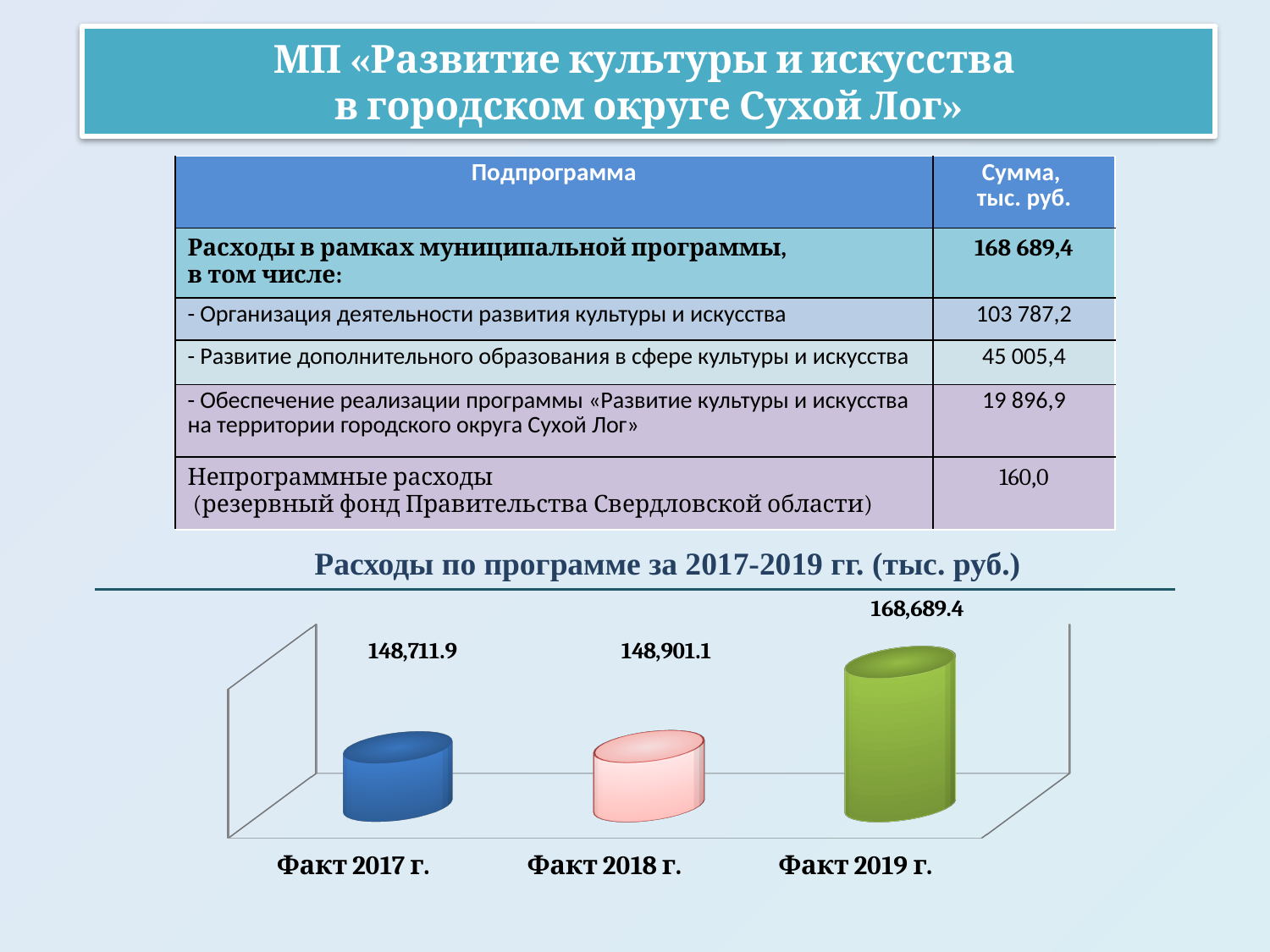
What is the difference between the values for Факт 2019 г. and Факт 2018 г.? 19,788.3 How many categories are shown in the chart? 3 What kind of chart is shown on the slide? Bar chart What is the difference between the values for Факт 2019 г. and Факт 2017 г.? 19,977.5 What is the value for Факт 2017 г. in the chart? 148,711.9 Which category has the highest value in the chart? Факт 2019 г. What is the value for Факт 2018 г. in the chart? 148,901.1 What is the value for Факт 2019 г. in the chart? 168,689.4 What is the title of the chart? Расходы по программе за 2017-2019 гг. (тыс. руб.) Do the values rise or fall from Факт 2017 г. to Факт 2019 г.? Rise Which category has the lowest value in the chart? Факт 2017 г. Which is larger, the value for Факт 2019 г. or the value for Факт 2017 г.? Факт 2019 г.